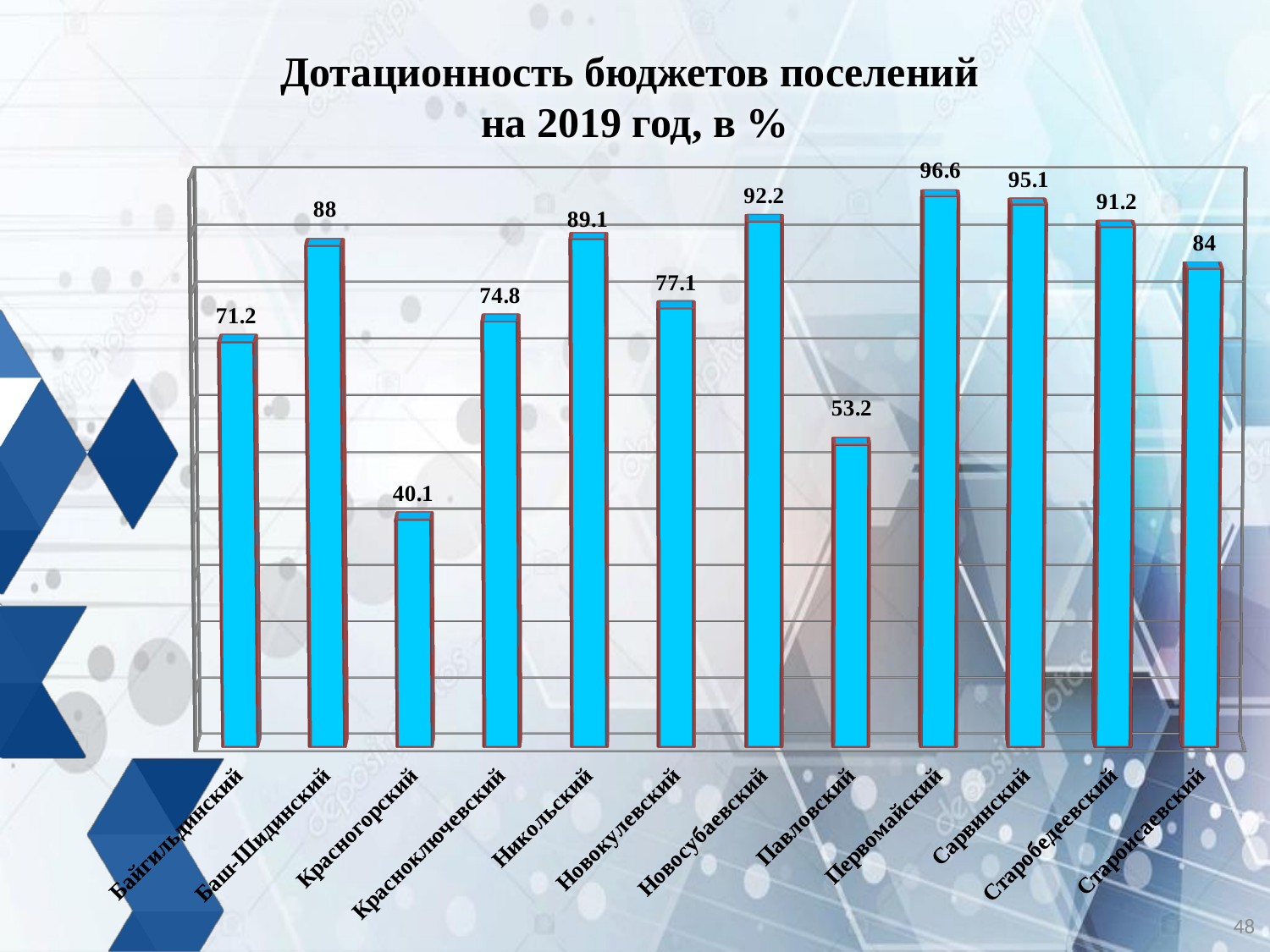
Which settlement has the lowest value? Красногорский What is the value for Байгильдинский? 71.2 What kind of chart is shown on the slide? bar chart What is the value for Красногорский? 40.1 What is the title of the chart? Дотационность бюджетов поселений на 2019 год, в % Which is larger, the value for Никольский or the value for Новокулевский? Никольский How many settlements are shown in the chart? 12 Which settlement has the highest value? Первомайский What is the difference between the values for Баш-Шидинский and Староисаевский? 4 What is the value for Старобедеевский? 91.2 What is the value for Павловский? 53.2 What is the difference between the values for Первомайский and Красногорский? 56.5